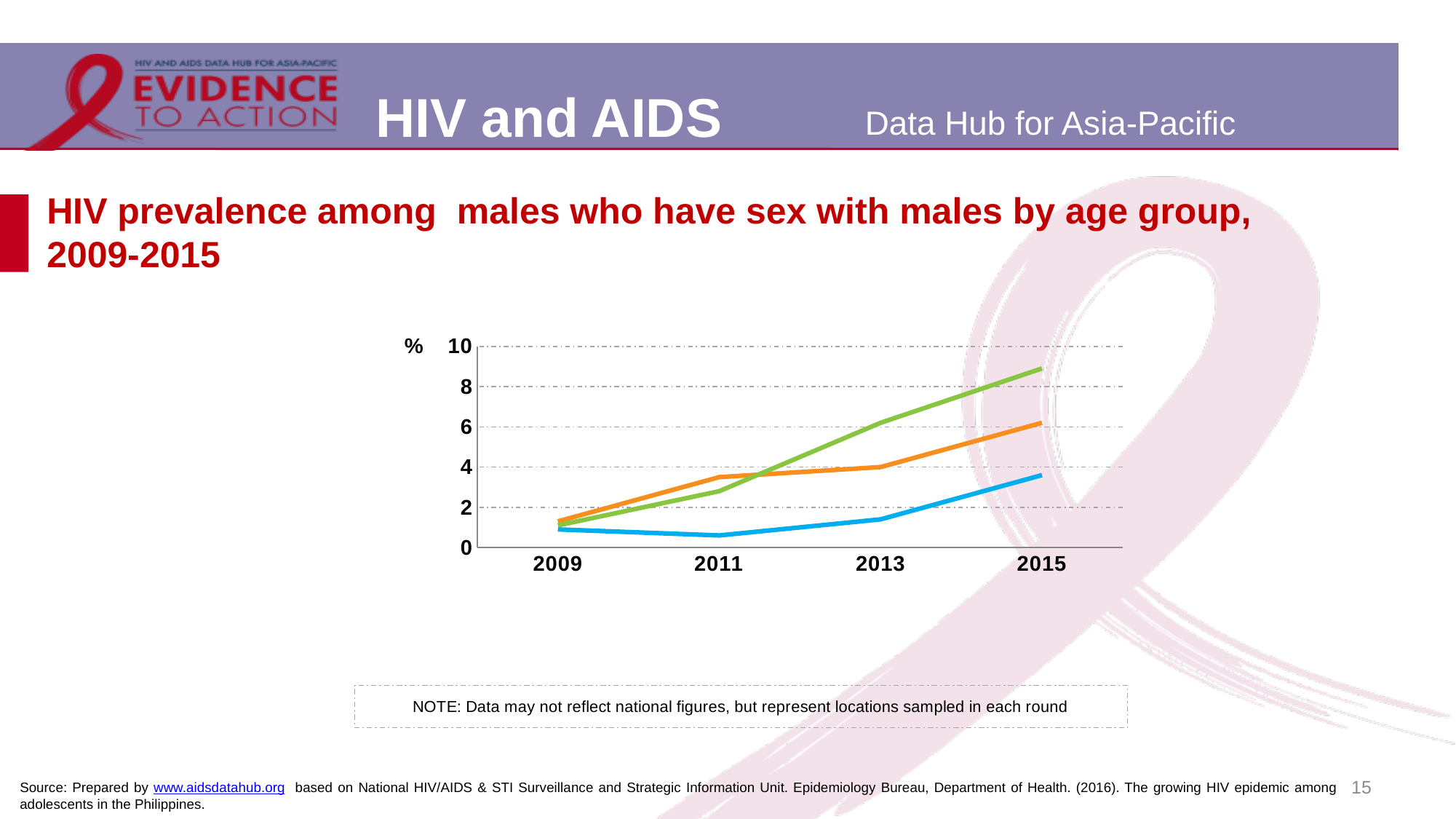
Is the value of the orange line in 2015 greater or less than 4? greater How many years are shown on the x axis of the chart? 4 Is the value of the blue line in 2011 greater or less than 2? less What unit is shown on the y axis of the chart? % Does the green line rise or fall from 2009 to 2015? rise Is the value of the green line in 2015 greater or less than 8? greater In 2013, which is larger: the green line or the orange line? the green line In 2011, which is larger: the orange line or the blue line? the orange line Which line is lowest in 2015? the blue line Which line is highest in 2015? the green line What kind of chart is shown on the slide? line chart How many lines are plotted on the chart? 3